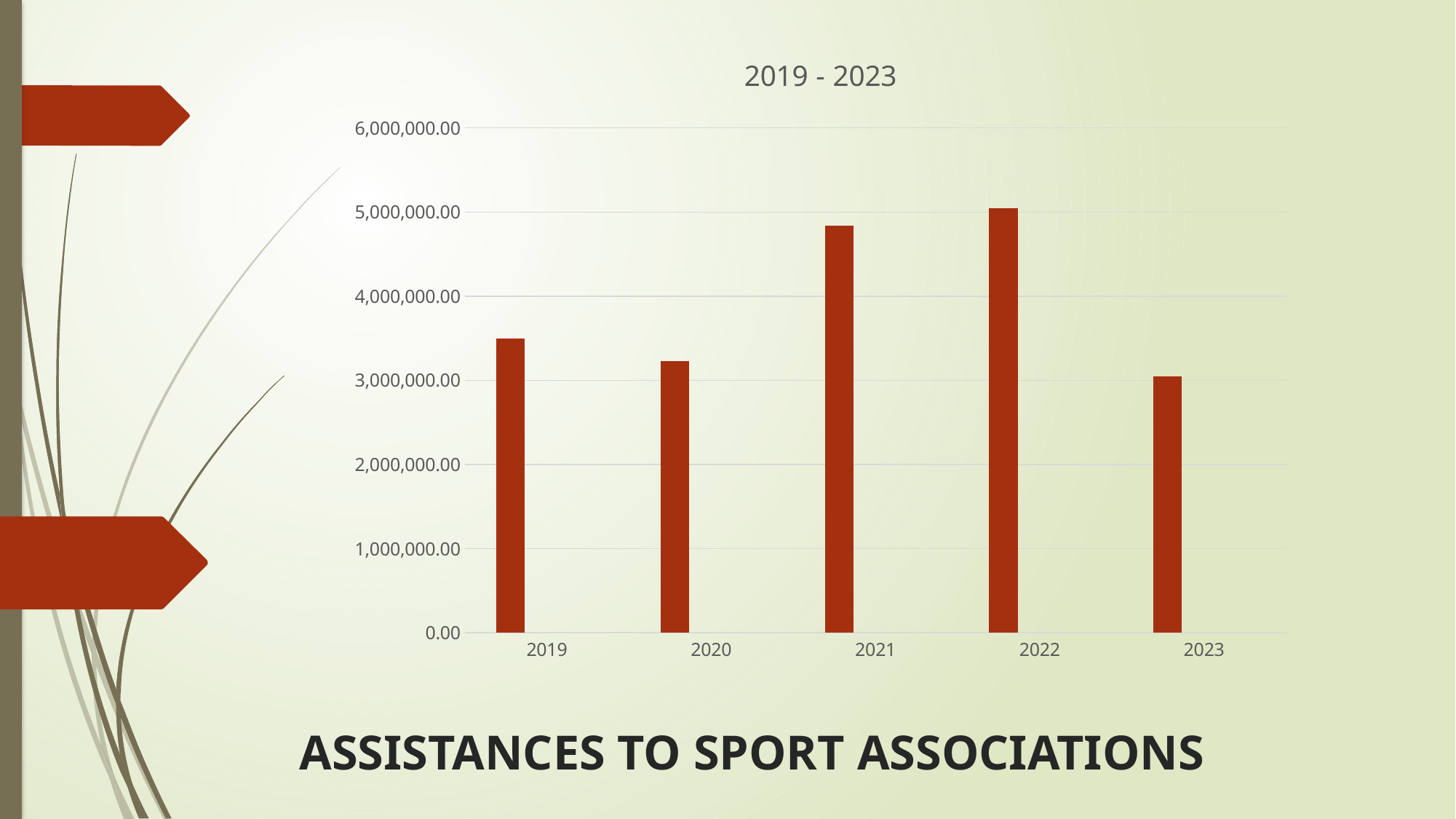
Which year has the highest value? 2022 What kind of chart is shown on the slide? bar chart Is the value for 2021 greater or less than 4,000,000.00? greater What is the title of the chart? 2019 - 2023 Which year has the lowest value? 2023 Is the value for 2023 greater or less than 4,000,000.00? less Is the value for 2020 greater or less than 4,000,000.00? less Which is larger, the value for 2019 or the value for 2020? 2019 Does the value rise or fall from 2020 to 2021? rise Does the value rise or fall from 2022 to 2023? fall How many years are plotted on the chart? 5